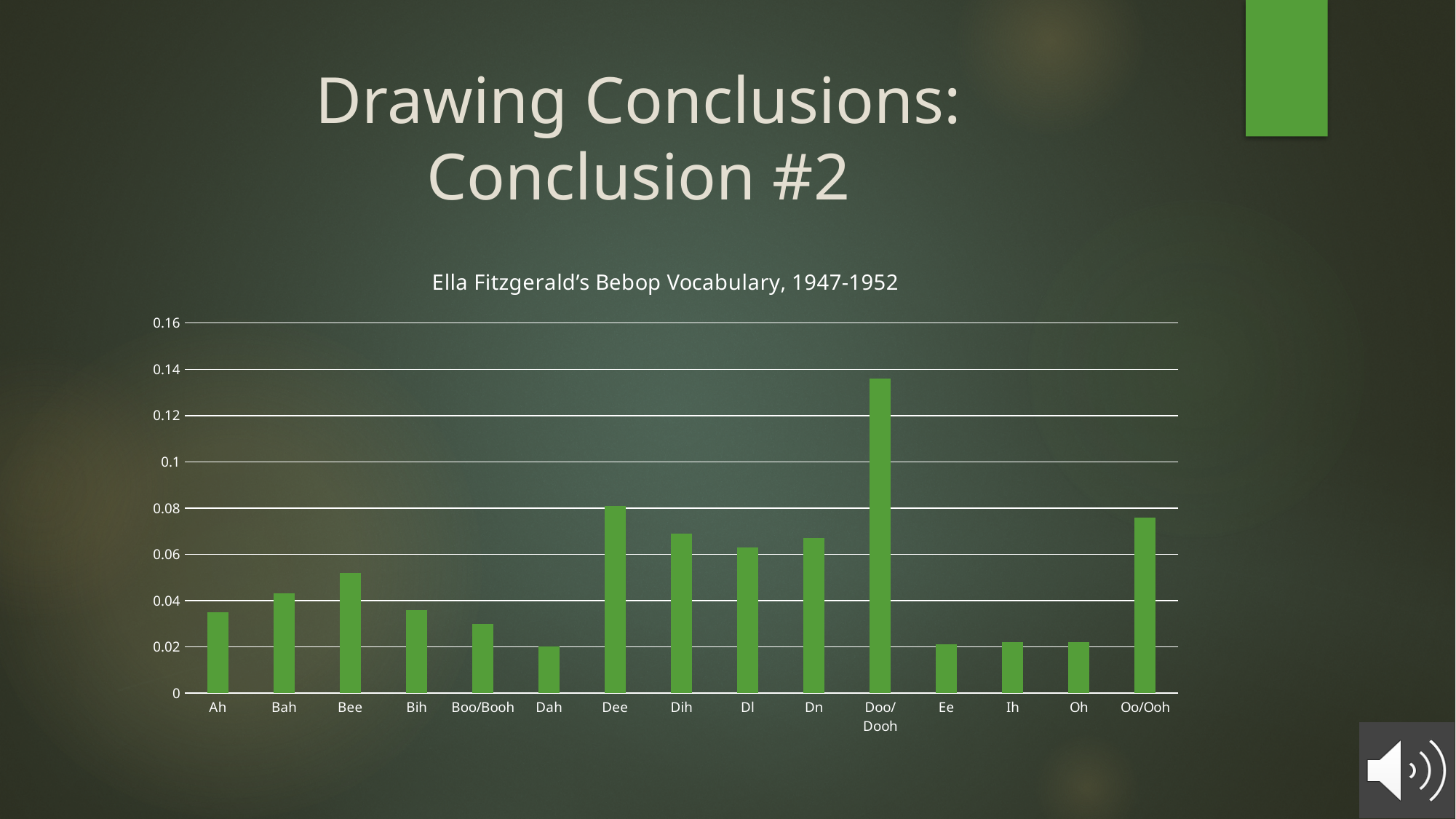
What type of chart is shown on the slide? bar chart Is the value for Doo/Dooh greater or less than 0.12? greater How many categories are plotted on the x axis of the chart? 15 What colour are the bars in the chart? green Which category has the highest bar in the chart? Doo/Dooh Is the value for Bee greater or less than 0.04? greater Which has the larger value, Bee or Bah? Bee Which has the larger value, Dee or Dih? Dee Is the value for Oo/Ooh greater or less than 0.08? less What is the title of the chart? Ella Fitzgerald's Bebop Vocabulary, 1947-1952